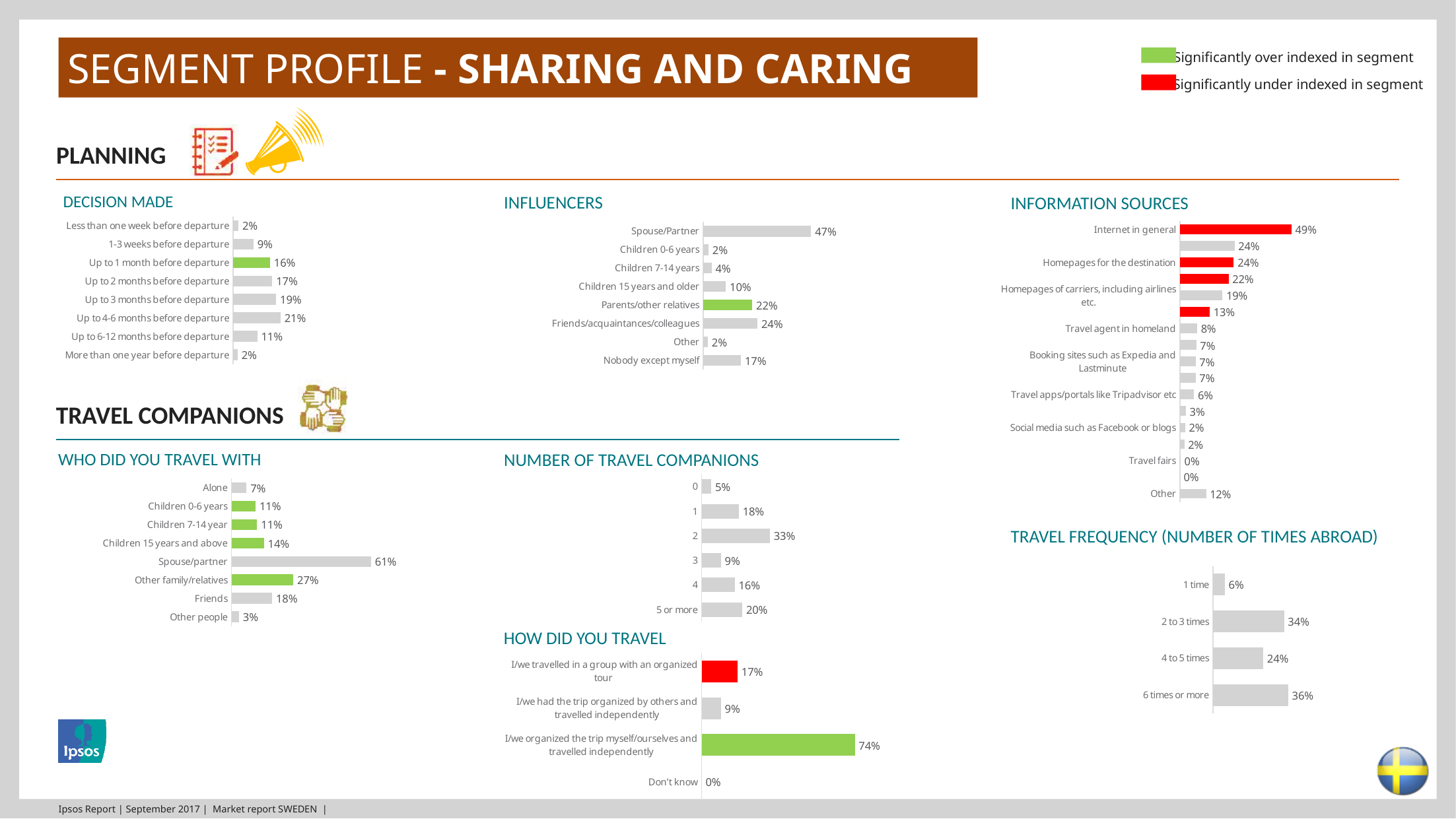
In the Influencers chart, what is the difference between 'Friends/acquaintances/colleagues' and 'Nobody except myself'? 7% In the Number of Travel Companions chart, which is larger: '4' or '5 or more'? 5 or more In the Decision Made chart, what is the value for 'Up to 4-6 months before departure'? 21% In the How Did You Travel chart, what is the value for 'I/we organized the trip myself/ourselves and travelled independently'? 74% In the Number of Travel Companions chart, which category has the highest value? 2 In the Who Did You Travel With chart, which category has the highest value? Spouse/partner In the Decision Made chart, which category has the highest value? Up to 4-6 months before departure In the Information Sources chart, what is the value for 'Internet in general'? 49% In the Who Did You Travel With chart, how many categories are shown? 8 In the Influencers chart, what is the value for 'Spouse/Partner'? 47% In the Information Sources chart, what is the value for 'Other'? 12% In the Travel Frequency (Number of Times Abroad) chart, what is the difference between '6 times or more' and '2 to 3 times'? 2%